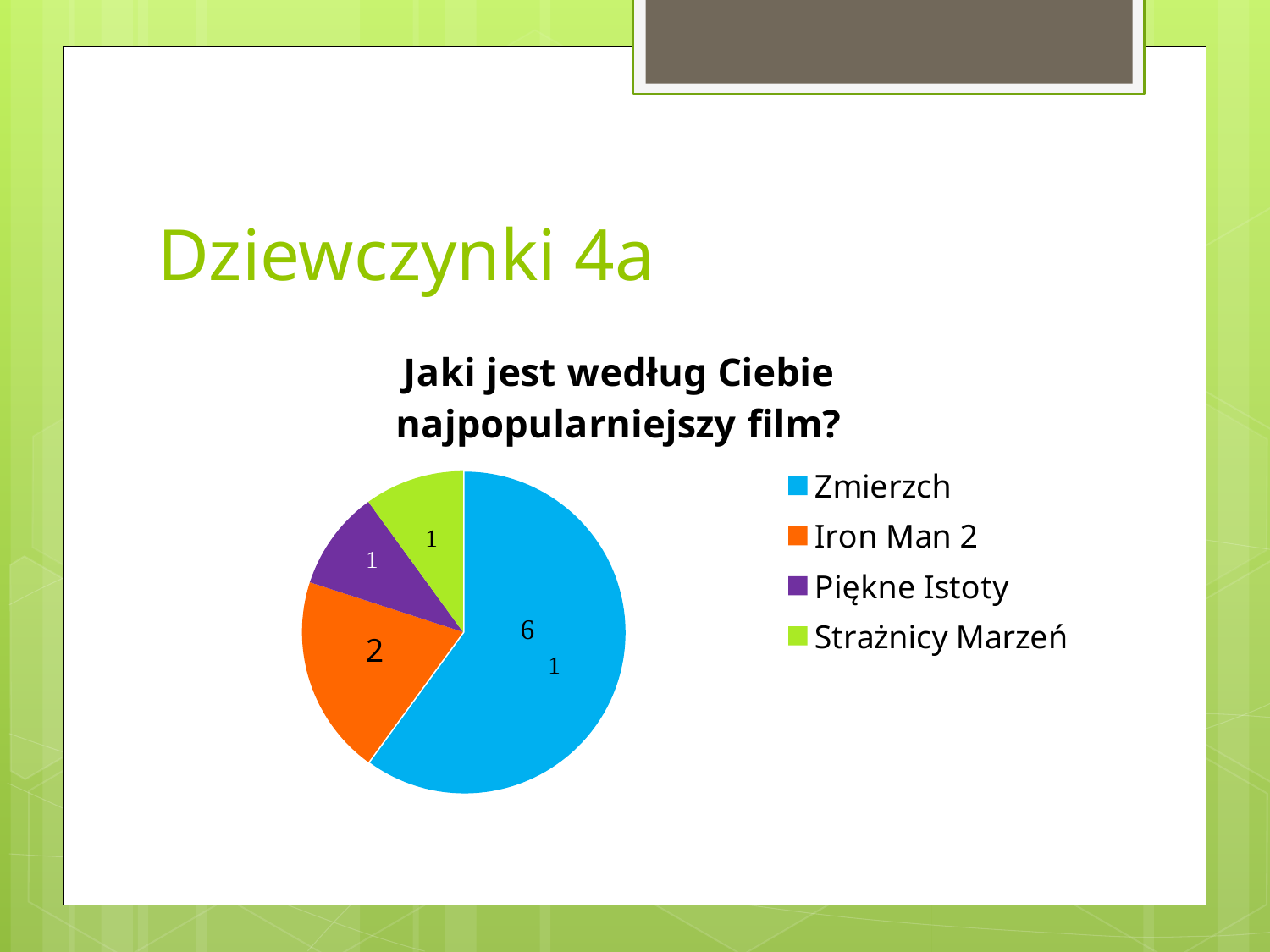
What is the value for Strażnicy Marzeń? 1 Which is larger, the value for Iron Man 2 or the value for Piękne Istoty? Iron Man 2 What is the value for Iron Man 2? 2 How many slices does the pie chart have? 4 What is the difference between the value for Iron Man 2 and the value for Strażnicy Marzeń? 1 What is the title of the chart? Jaki jest według Ciebie najpopularniejszy film? What is the value for Piękne Istoty? 1 How many entries does the chart legend list? 4 Which film has the largest slice of the pie? Zmierzch What kind of chart is shown on the slide? pie chart Which colour represents Zmierzch in the chart? blue